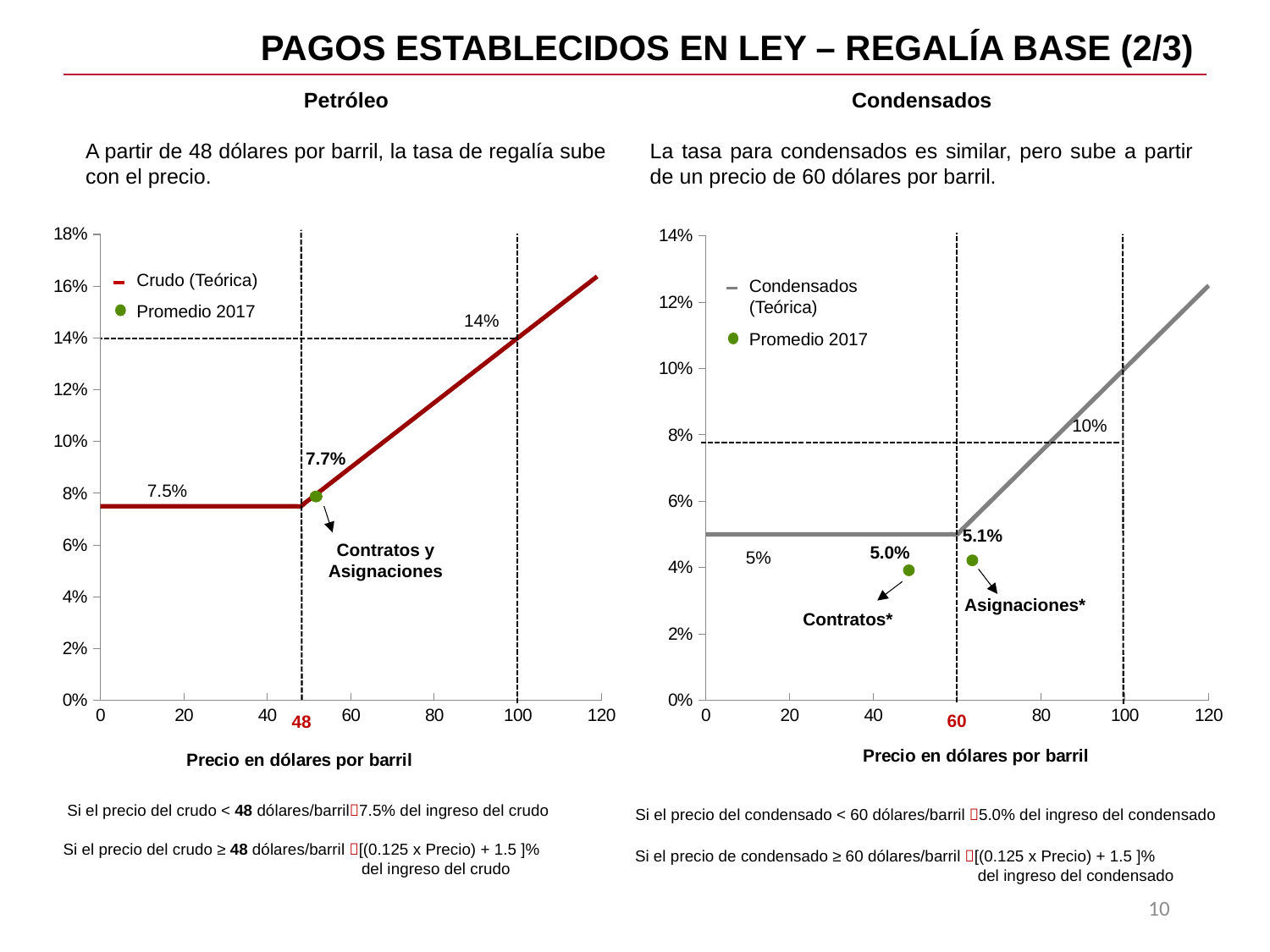
In the Condensados chart, is the theoretical rate at a price of 80 dollars per barrel greater or less than 8%? less In the Condensados chart, what is the Promedio 2017 value for Asignaciones*? 5.1% In the Petróleo chart, what is the royalty rate shown for prices below 48 dollars per barrel? 7.5% How many entries does the legend of the Condensados chart list? 2 In the Petróleo chart, what is the Promedio 2017 value for Contratos y Asignaciones? 7.7% In the Petróleo chart, how does the theoretical rate change as the price rises above 48 dollars per barrel? It rises In the Petróleo chart, what rate is labelled at a price of 100 dollars per barrel? 14% In the Petróleo chart, is the theoretical rate at a price of 80 dollars per barrel greater or less than 10%? greater In the Condensados chart, what rate is labelled at a price of 100 dollars per barrel? 10% In the Condensados chart, what is the Promedio 2017 value for Contratos*? 5.0% In the Condensados chart, what is the royalty rate shown for prices below 60 dollars per barrel? 5% What is the x-axis title of the Petróleo chart? Precio en dólares por barril